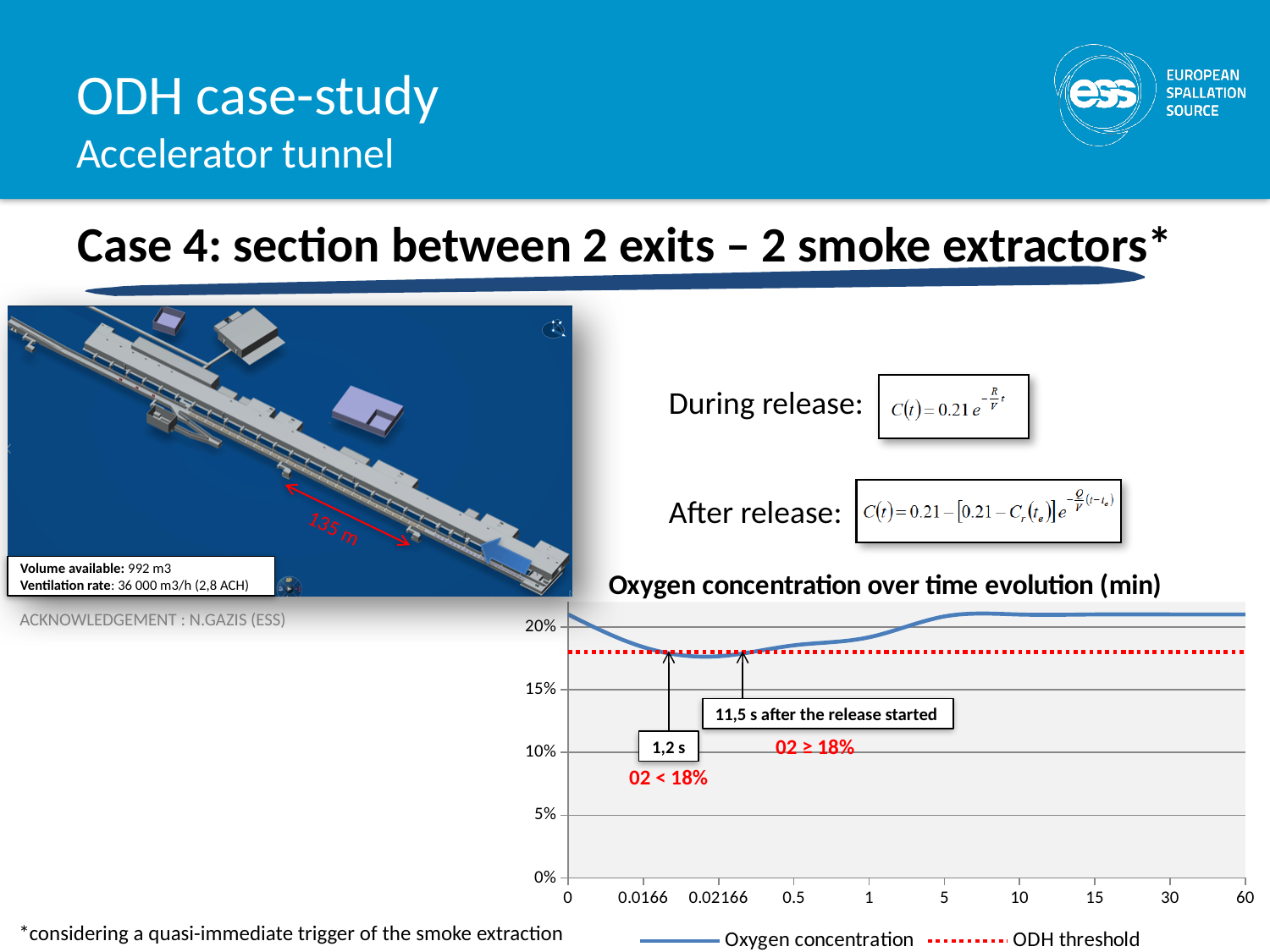
What are the two series named in the legend of the oxygen concentration chart? Oxygen concentration and ODH threshold How many series does the legend of the oxygen concentration chart list? 2 Which is larger, the oxygen concentration at x = 0 or at x = 0.0166? x = 0 Is the oxygen concentration at x = 0.0166 greater or less than 20%? less What kind of chart is shown under the title 'Oxygen concentration over time evolution (min)'? line chart Is the oxygen concentration at x = 0.0166 greater or less than 15%? greater How many tick labels are shown on the x axis of the oxygen concentration chart? 10 Is the oxygen concentration at x = 60 greater or less than 20%? greater Does the oxygen concentration rise or fall between x = 0 and x = 0.0166? fall What is the title of the chart on the slide? Oxygen concentration over time evolution (min) Does the oxygen concentration rise or fall between x = 1 and x = 5? rise